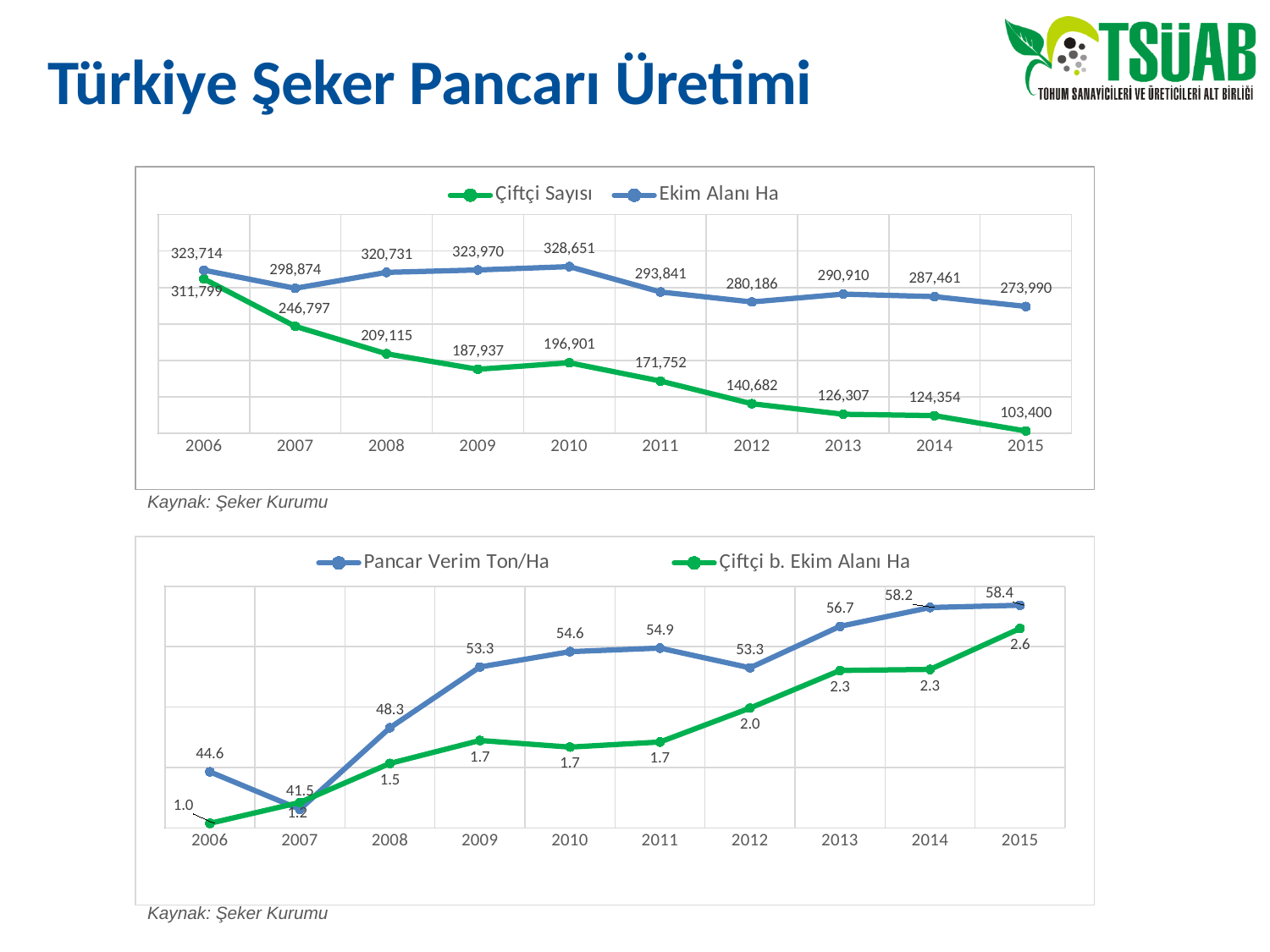
In the bottom chart, what is the Pancar Verim Ton/Ha value for 2013? 56.7 In the top chart, what is the difference between the Çiftçi Sayısı values for 2006 and 2007? 65,002 In the top chart, what is the Ekim Alanı Ha value for 2010? 328,651 In the top chart, what is the Çiftçi Sayısı value for 2015? 103,400 In the top chart, which year has the highest Ekim Alanı Ha value? 2010 In the top chart, which year has the lowest Çiftçi Sayısı value? 2015 In the bottom chart, which year has the lowest Pancar Verim Ton/Ha value? 2007 In the bottom chart, how many years are plotted on the x axis? 10 What type of chart is the bottom chart? line chart In the bottom chart, what is the Çiftçi b. Ekim Alanı Ha value for 2012? 2.0 In the top chart, does Çiftçi Sayısı generally rise or fall from 2006 to 2015? fall In the top chart, how many series does the legend list? 2